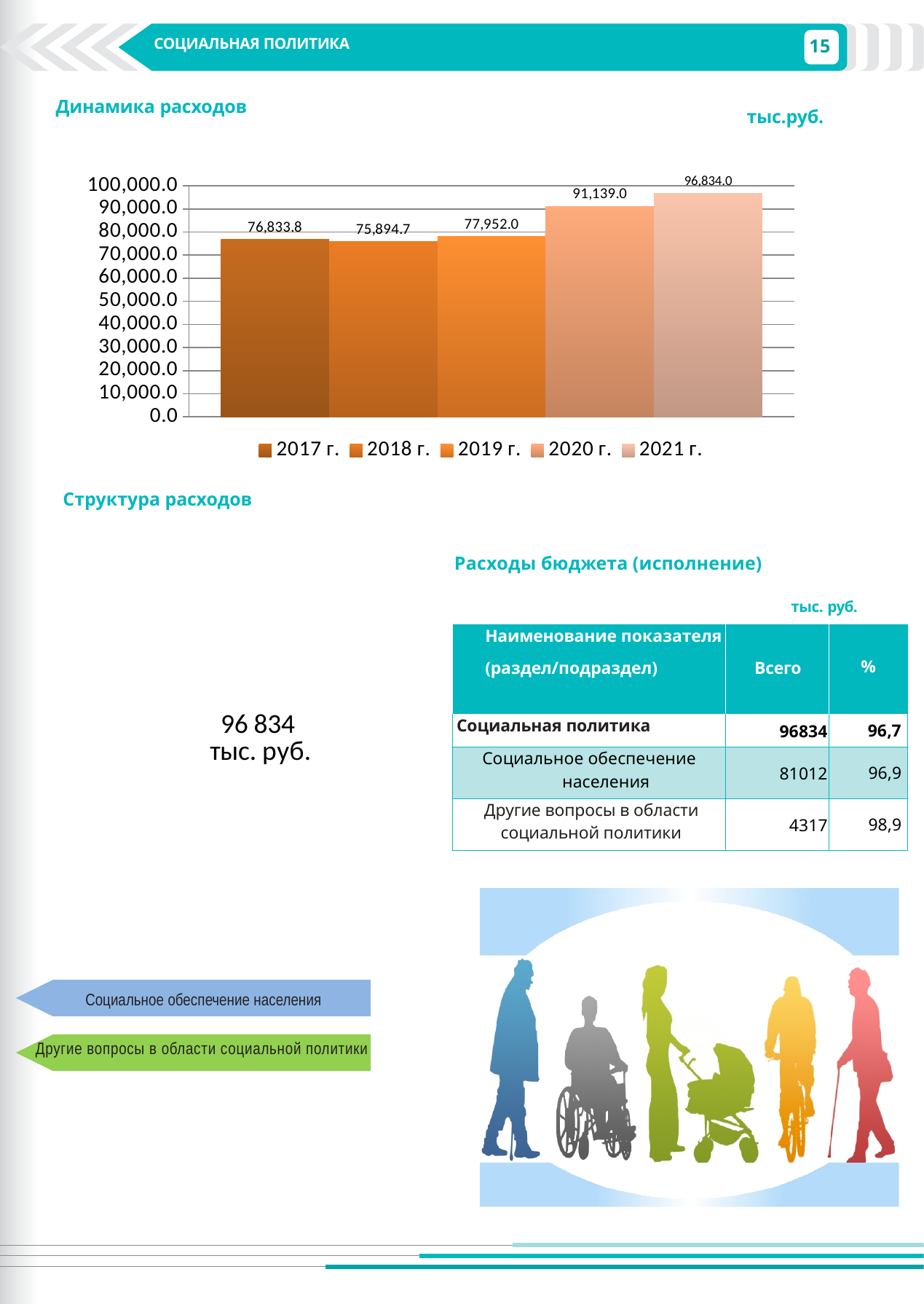
How many entries does the legend of the Динамика расходов chart list? 5 Which is larger in the Динамика расходов chart, the value for 2019 г. or 2020 г.? 2020 г. Which year has the lowest value in the Динамика расходов chart? 2018 г. What is the difference between the values for 2019 г. and 2018 г. in the Динамика расходов chart? 2,057.3 Is the value for 2018 г. in the Динамика расходов chart greater or less than 80,000.0? less How many bars are shown in the Динамика расходов chart? 5 What type of chart is the Динамика расходов chart? bar chart What is the difference between the values for 2021 г. and 2020 г. in the Динамика расходов chart? 5,695.0 What is the value for 2020 г. in the Динамика расходов chart? 91,139.0 What is the value for 2021 г. in the Динамика расходов chart? 96,834.0 What is the value for 2017 г. in the Динамика расходов chart? 76,833.8 Which year has the highest value in the Динамика расходов chart? 2021 г.